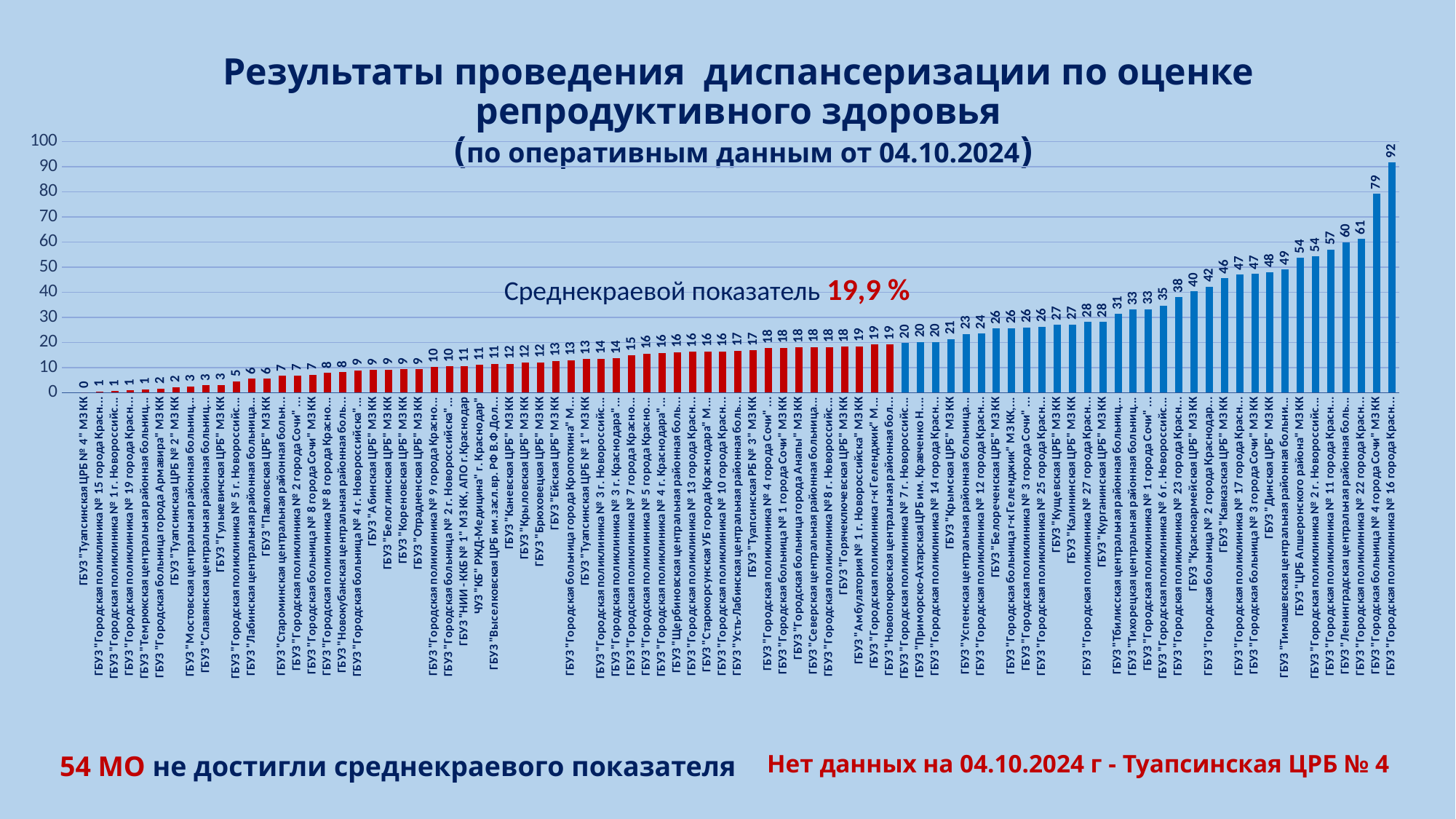
Is the value for ГБУЗ "Ленинградская центральная районная больница" greater or less than 50? greater What type of chart is shown on the slide? bar chart Which has a larger value: ГБУЗ "Кавказская ЦРБ" МЗ КК or ГБУЗ "Курганинская ЦРБ" МЗ КК? ГБУЗ "Кавказская ЦРБ" МЗ КК What is the value for ГБУЗ "Крымская ЦРБ" МЗ КК? 21 What is the average regional indicator (среднекраевой показатель) stated on the chart? 19,9 % What is the value for ГБУЗ "Красноармейская ЦРБ" МЗ КК? 40 What is the difference between the values for ГБУЗ "Городская поликлиника № 16 города Краснодара" and ГБУЗ "Городская поликлиника № 4 города Сочи" МЗ КК? 74 What is the value for ГБУЗ "Городская поликлиника № 4 города Сочи" МЗ КК? 18 What is the value for ГБУЗ "Динская ЦРБ" МЗ КК? 48 What is the value for ГБУЗ "Туапсинская ЦРБ № 2" МЗ КК? 2 Which organisation has the highest value on the chart? ГБУЗ "Городская поликлиника № 16 города Краснодара" Do the values rise or fall moving from left to right along the x axis? rise